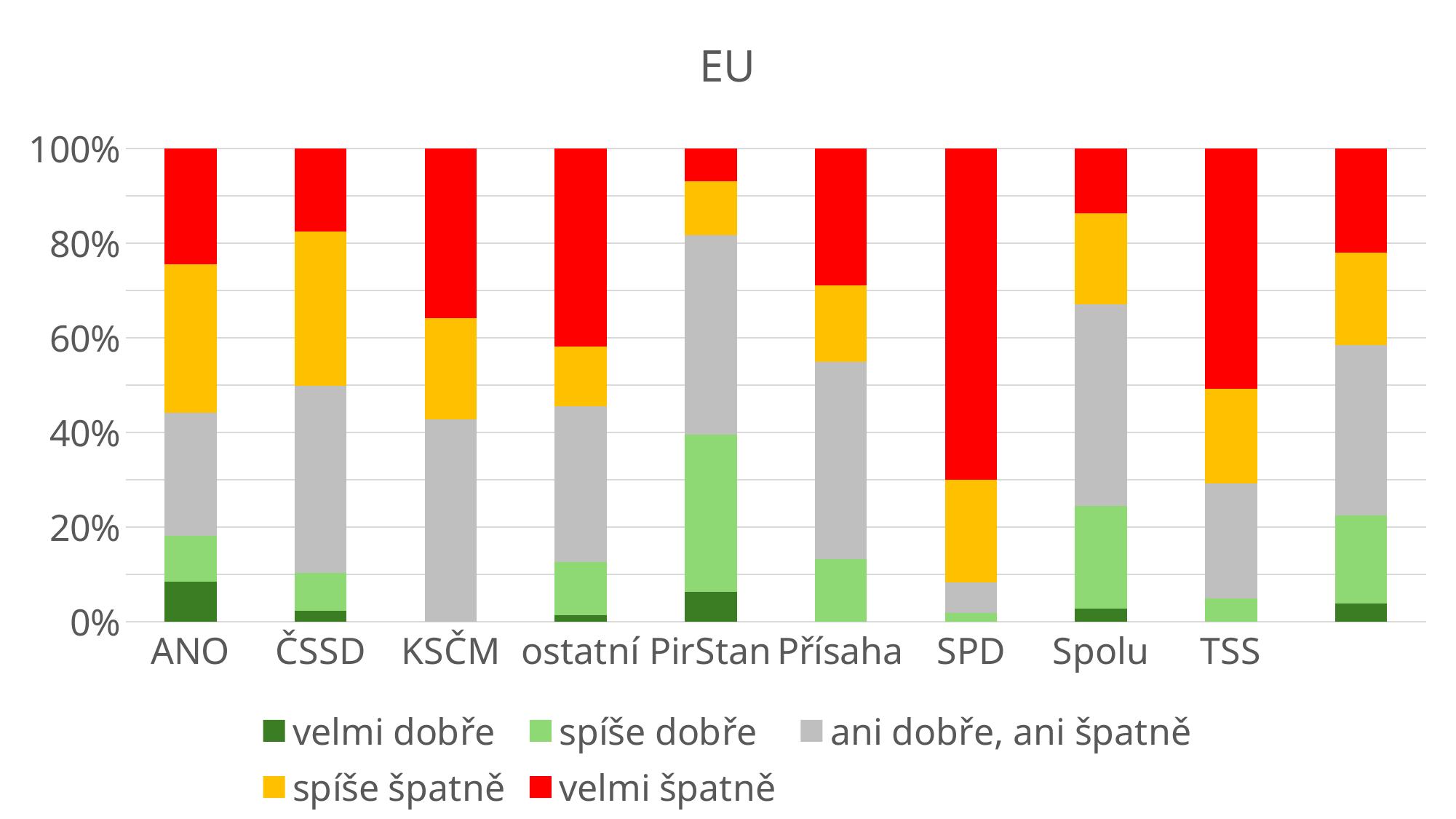
What kind of chart is shown on the slide? Stacked bar chart Which party has the smallest 'velmi špatně' segment? PirStan Which party has the largest 'velmi špatně' segment? SPD Which party has the largest 'spíše dobře' segment? PirStan Is the 'velmi špatně' share for SPD greater or less than 60%? greater Which has the larger 'ani dobře, ani špatně' segment, KSČM or SPD? KSČM What is the title of the chart? EU How many bars are plotted in the chart? 10 How many series does the legend list? 5 Is the 'spíše dobře' share for PirStan greater or less than 20%? greater Is the 'velmi špatně' share for PirStan greater or less than 10%? less Which has the larger 'velmi špatně' segment, SPD or Spolu? SPD